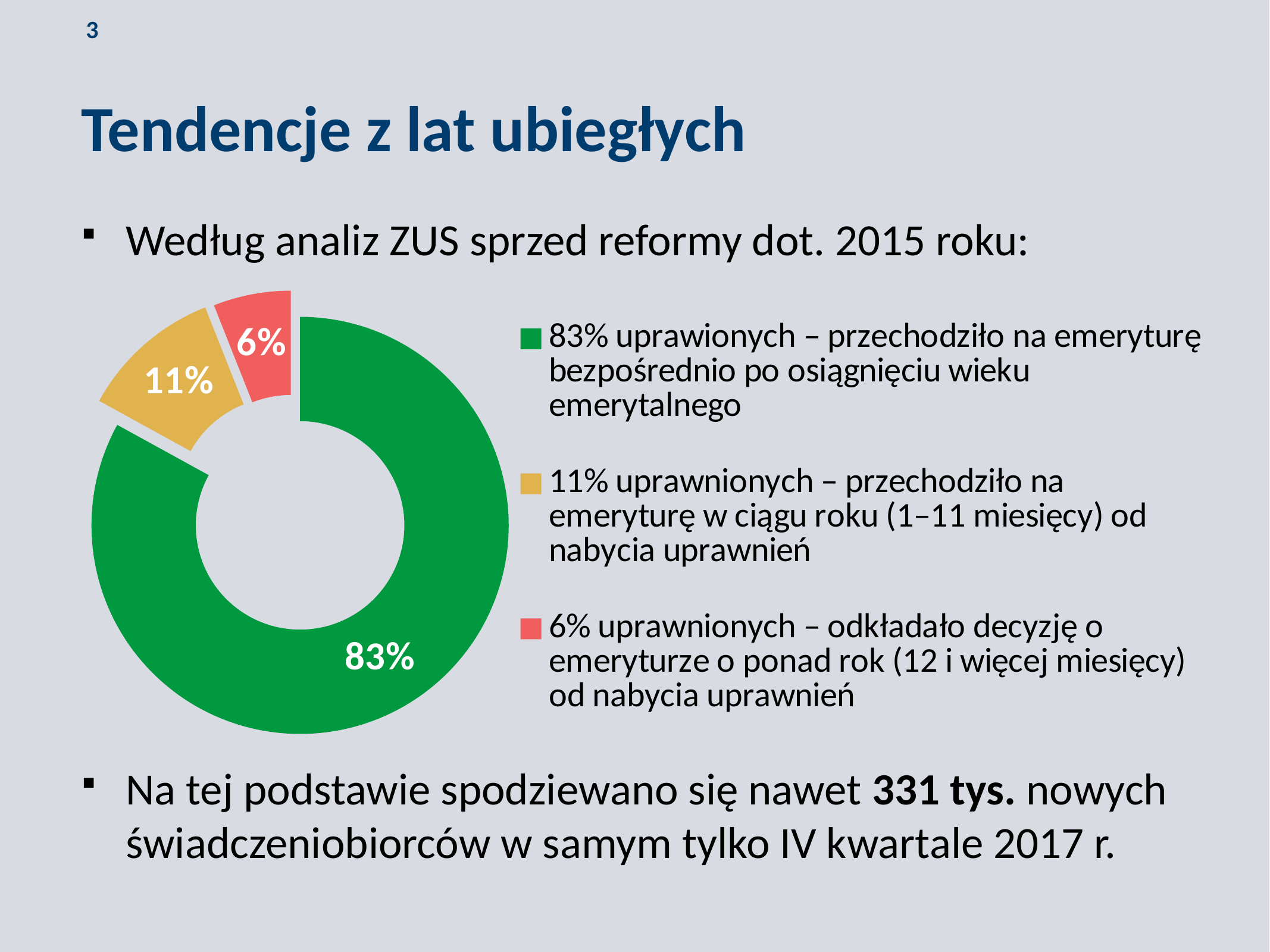
What is the difference between the largest slice and the smallest slice of the pie chart? 77% What share of the pie chart is taken by the yellow slice (those who retired within a year of acquiring rights)? 11% What share of the pie chart is taken by the red slice (those who postponed retirement by more than a year)? 6% Which is larger in the pie chart: the yellow slice or the red slice? The yellow slice (11%) Which slice of the pie chart is the smallest? 6% (red) What kind of chart is shown on the slide? Pie chart (doughnut) Which slice of the pie chart is the largest? 83% (green) What is the total of the three slices shown in the pie chart? 100% What share of the pie chart is taken by the green slice (those who retired immediately after reaching retirement age)? 83% How many slices does the pie chart have? 3 What is the difference between the yellow slice and the red slice of the pie chart? 5% What colour is the slice representing 83% in the pie chart? Green